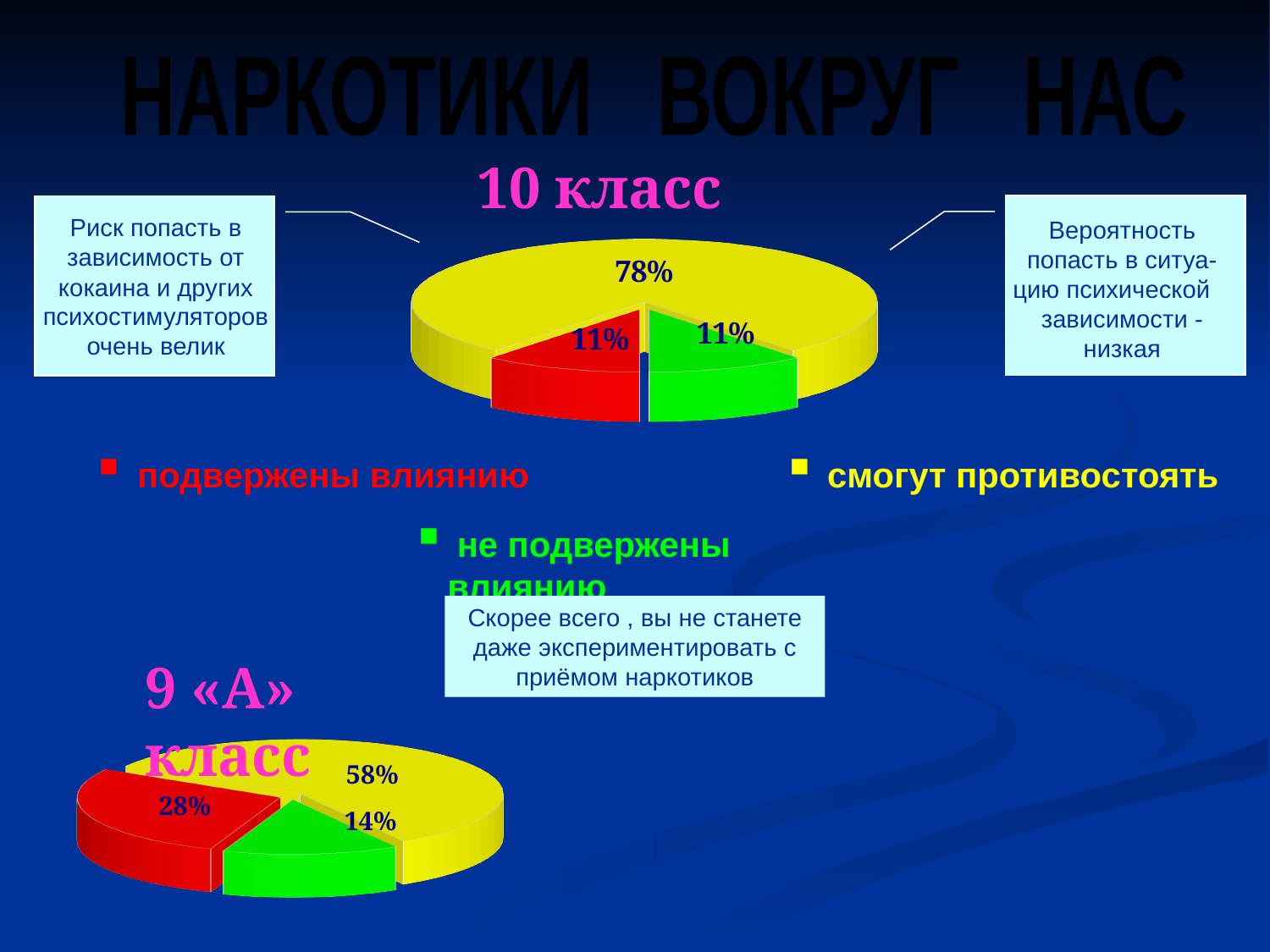
In the "9 «А» класс" pie chart, what share is shown for "подвержены влиянию" (red)? 28% In the "9 «А» класс" pie chart, what share is shown for "не подвержены влиянию" (green)? 14% Which class has the larger share for "подвержены влиянию": "10 класс" or "9 «А» класс"? 9 «А» класс In the "10 класс" pie chart, what share is shown for "смогут противостоять" (yellow)? 78% In the "10 класс" pie chart, which category has the largest slice? смогут противостоять What kind of chart is used for the "10 класс" data? pie chart How many categories does the legend list for the pie charts? 3 Which colour represents "не подвержены влиянию" in the pie charts? green In the "9 «А» класс" pie chart, which category has the smallest slice? не подвержены влиянию In the "9 «А» класс" pie chart, what is the difference between the "смогут противостоять" share and the "подвержены влиянию" share? 30% How many slices does the "10 класс" pie chart have? 3